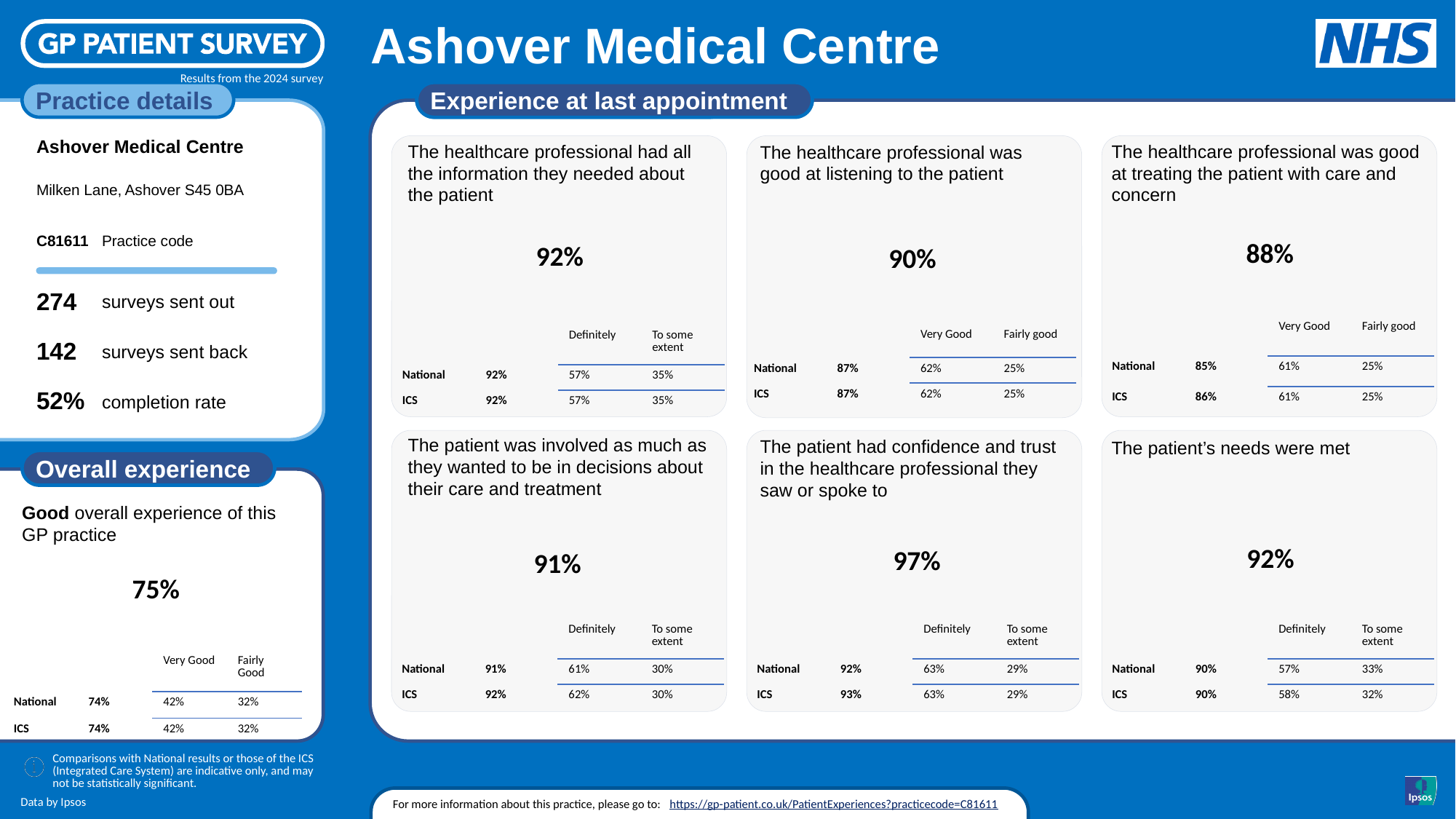
In the 'Experience at last appointment' section, which is higher: the practice's value for 'good at listening to the patient' or for 'good at treating the patient with care and concern'? good at listening to the patient In the 'Experience at last appointment' section, what is the National value for 'The patient's needs were met'? 90% In the 'Overall experience' panel, what is the ICS value for good overall experience? 74% In the 'Experience at last appointment' section, what is the practice's value for 'The healthcare professional was good at listening to the patient'? 90% In the 'Experience at last appointment' section, what is the practice's value for 'The healthcare professional had all the information they needed about the patient'? 92% In the 'Experience at last appointment' section, how many percentage points higher is the practice's value for 'The patient had confidence and trust in the healthcare professional' than the National value? 5 In the 'Overall experience' panel, what percentage of patients reported a good overall experience of this GP practice? 75% In the 'Experience at last appointment' section, which measure has the highest practice value? The patient had confidence and trust in the healthcare professional they saw or spoke to In the 'Experience at last appointment' section, which measure has the lowest practice value? The healthcare professional was good at treating the patient with care and concern In the 'Experience at last appointment' section, what is the practice's value for 'The healthcare professional was good at treating the patient with care and concern'? 88% How many measures are shown in the 'Experience at last appointment' section? 6 In the 'Experience at last appointment' section, what is the practice's value for 'The patient had confidence and trust in the healthcare professional they saw or spoke to'? 97%